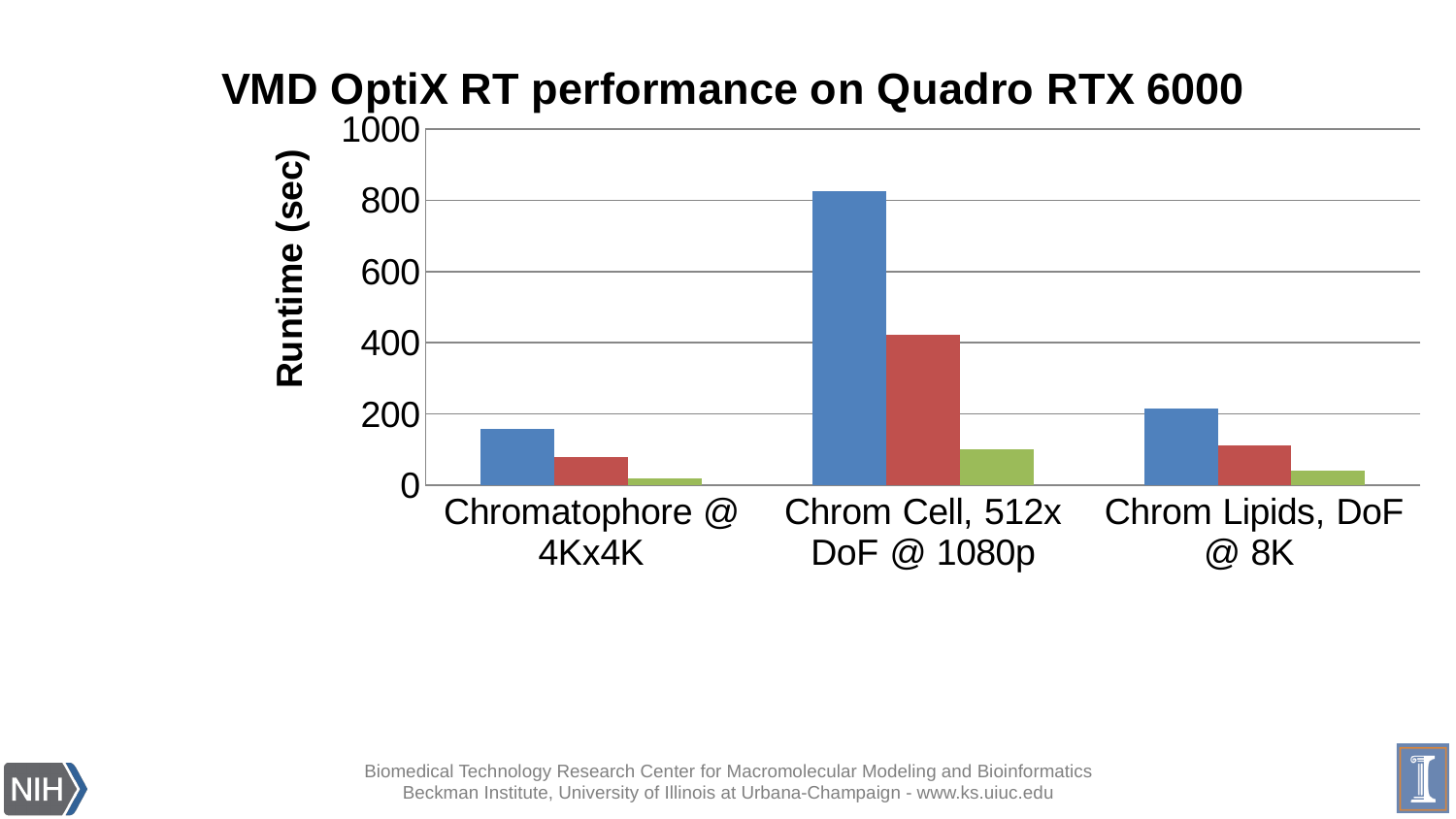
Is the red bar for Chrom Cell, 512x DoF @ 1080p greater or less than 200? greater Is the blue bar for Chrom Cell, 512x DoF @ 1080p greater or less than 600? greater Which category has the tallest blue bar? Chrom Cell, 512x DoF @ 1080p How many categories are shown on the x axis? 3 For Chrom Lipids, DoF @ 8K, which is larger, the blue bar or the red bar? the blue bar What is the label of the vertical axis? Runtime (sec) What kind of chart is shown on the slide? bar chart Is the blue bar for Chrom Lipids, DoF @ 8K greater or less than 400? less Which category has the shortest green bar? Chromatophore @ 4Kx4K How many bars are plotted for each category? 3 What is the title of the chart? VMD OptiX RT performance on Quadro RTX 6000